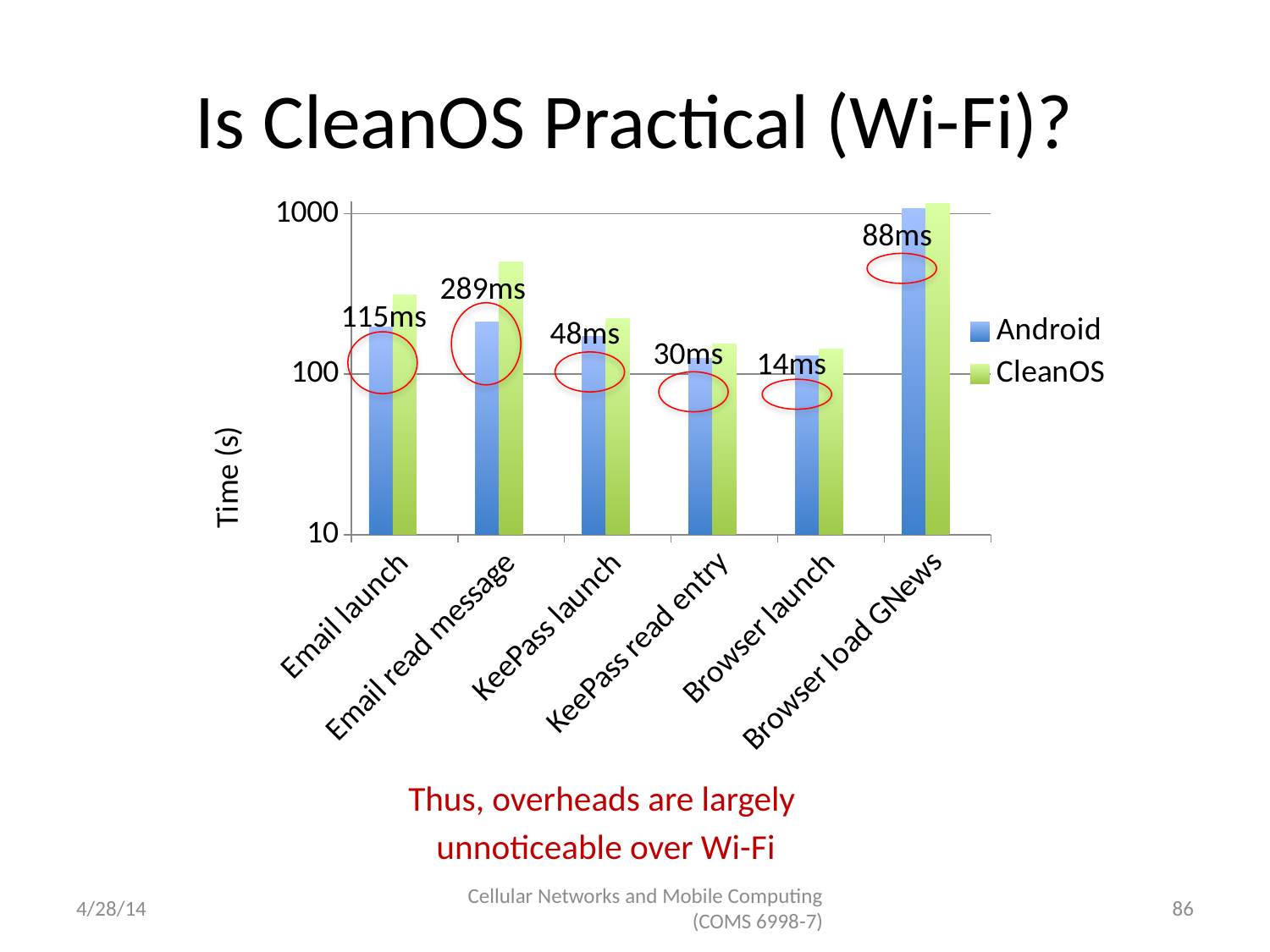
Which category has the highest Android value? Browser load GNews Is the CleanOS value for Browser load GNews greater or less than 1000? greater How many categories are shown on the x axis of the chart? 6 Which category has the highest CleanOS value? Browser load GNews Which is larger for Android: Email read message or KeePass launch? Email read message What is the label on the chart's y axis? Time (s) What kind of chart is shown on the slide? bar chart How many series does the chart's legend list? 2 What are the two series named in the chart's legend? Android and CleanOS Which is larger for CleanOS: Email read message or Email launch? Email read message Is the Android value for Email launch greater or less than 100? greater Is the CleanOS value for Email read message greater or less than 1000? less